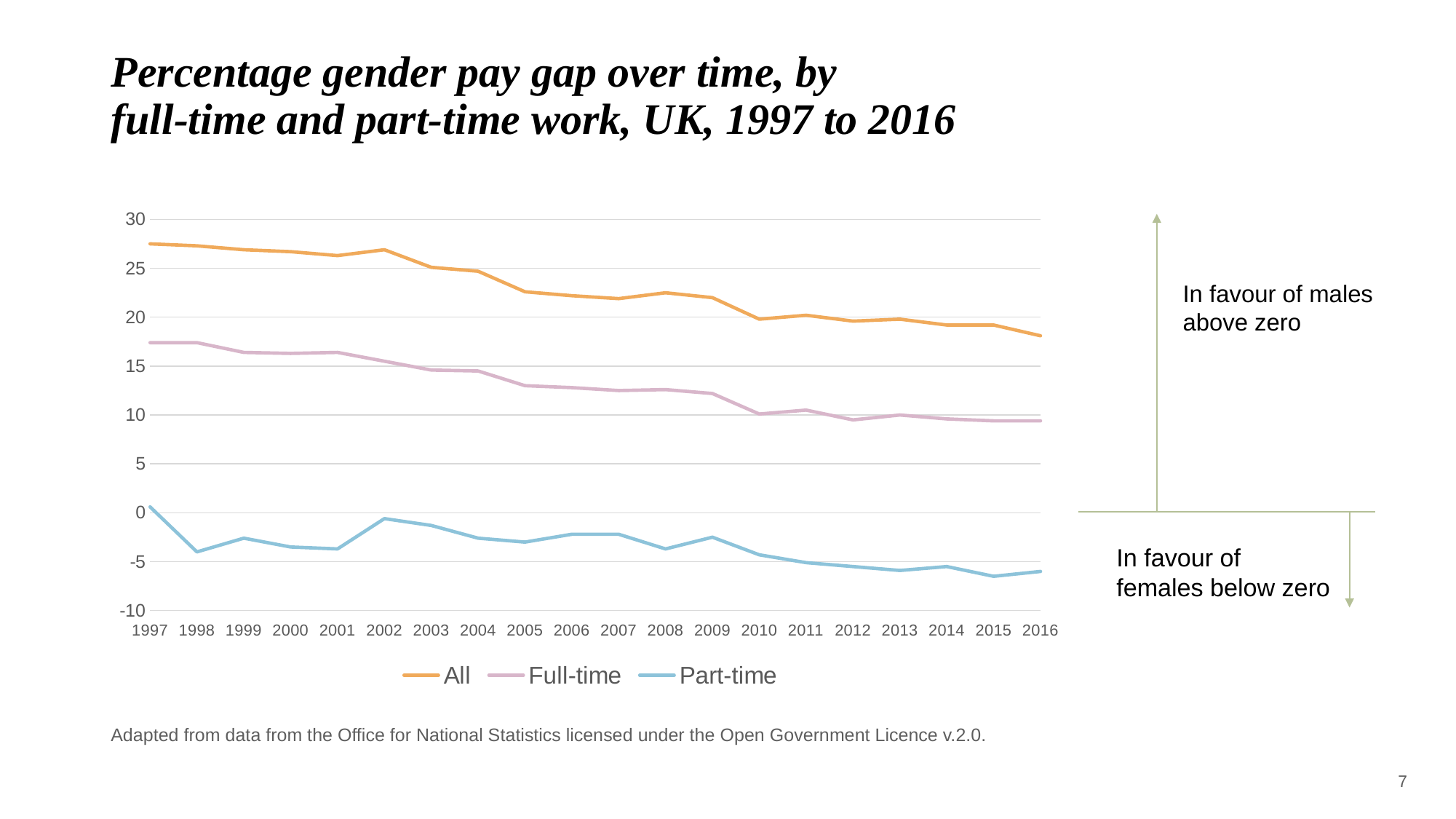
Does the All series rise or fall from 1997 to 2016? fall Which series has the lowest value in 2016? Part-time Is the value for Full-time in 1997 greater or less than 15? greater Is the value for Part-time in 2015 greater or less than -5? less How many years are shown along the x axis? 20 Does the Full-time series rise or fall from 1997 to 2016? fall What colour is the line for the All series? orange What kind of chart is shown on the slide? line chart How many series does the legend list? 3 Is the value for All in 1997 greater or less than 25? greater In 2010, which is larger, the value for All or the value for Full-time? All